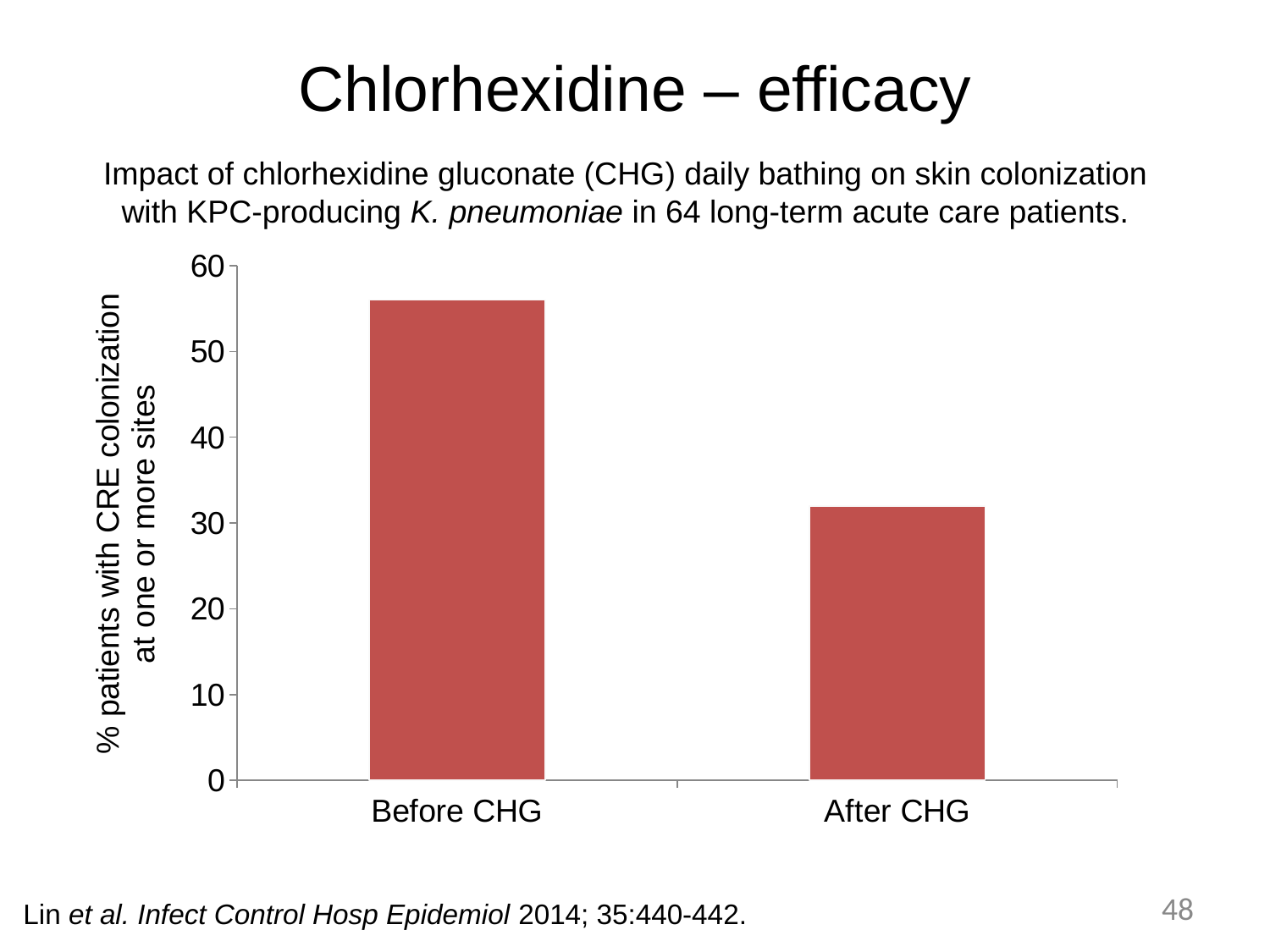
Which category has the lowest value? After CHG What kind of chart is shown on the slide? bar chart Is the value for Before CHG greater or less than 60? less Do the values rise or fall from Before CHG to After CHG? fall How many categories are plotted on the x axis? 2 Which category has the highest value? Before CHG What is the label of the y axis? % patients with CRE colonization at one or more sites Is the value for Before CHG greater or less than 50? greater Which is larger, the value for Before CHG or the value for After CHG? Before CHG What is the highest tick value shown on the y axis? 60 Is the value for After CHG greater or less than 40? less